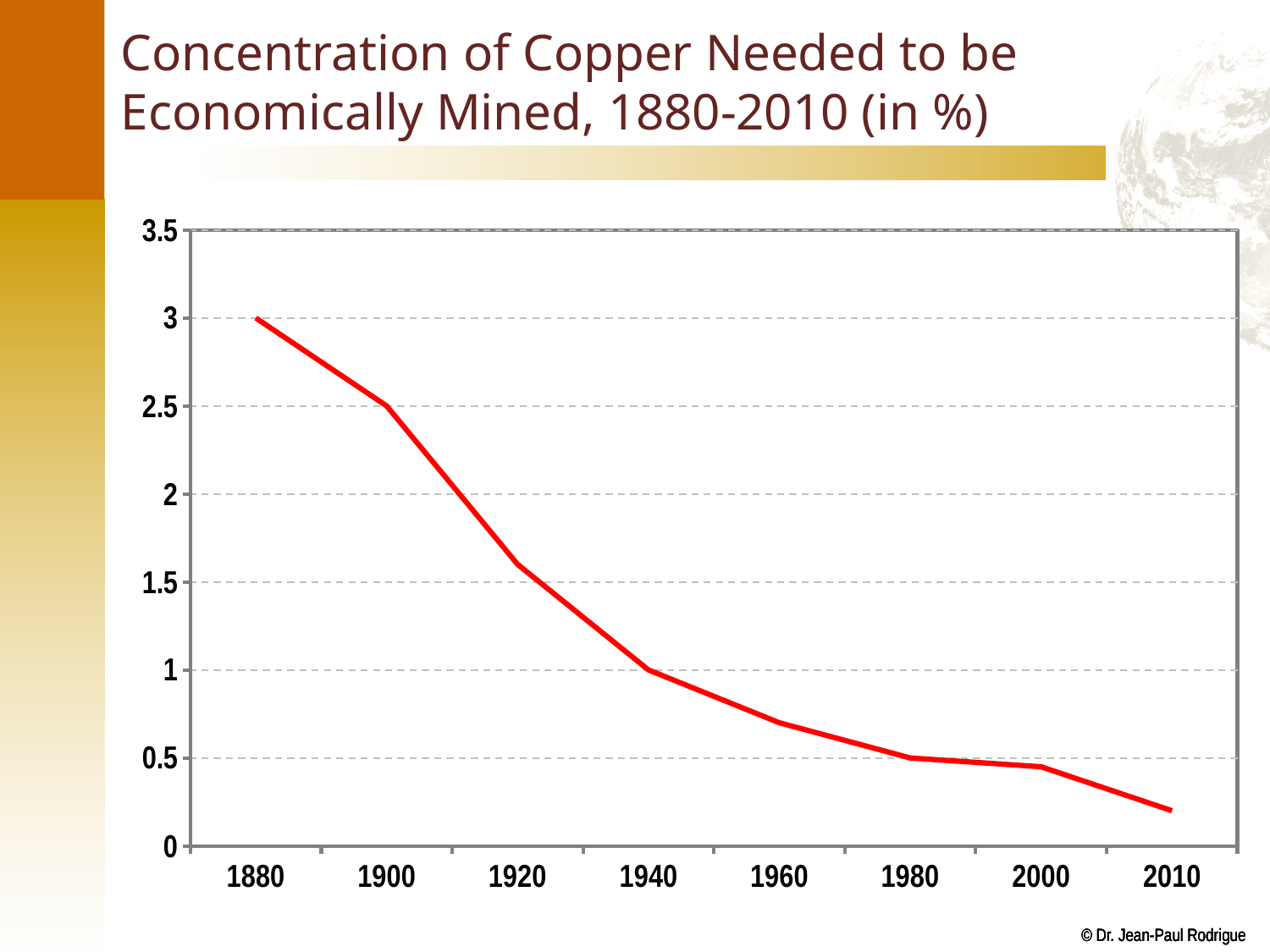
How many years are labelled on the x axis? 8 Is the value for 2010 greater or less than 0.5? less Which year has the highest concentration of copper needed to be economically mined? 1880 What is the concentration value for 1880? 3 What kind of chart is shown on the slide? line chart Which is larger, the value for 1900 or the value for 1980? 1900 What is the title of the chart? Concentration of Copper Needed to be Economically Mined, 1880-2010 (in %) Do the values rise or fall from 1880 to 2010? fall Is the value for 1920 greater or less than 2? less Is the value for 1960 greater or less than 0.5? greater What is the concentration value for 1940? 1 Which year has the lowest concentration of copper needed to be economically mined? 2010